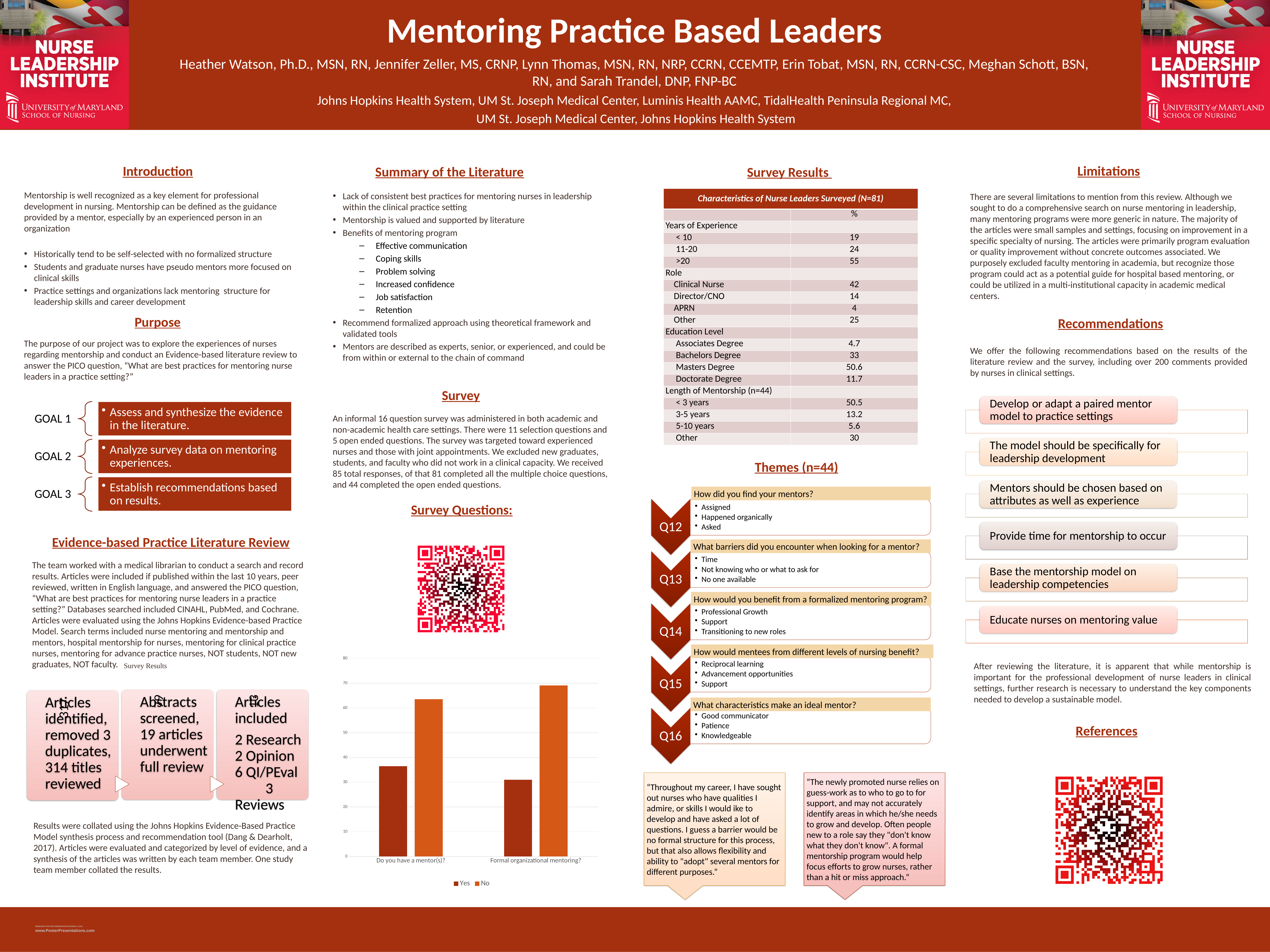
In the Survey Results chart, is the No value for "Do you have a mentor(s)?" greater or less than 60? greater In the Survey Results chart, is the Yes value for "Do you have a mentor(s)?" greater or less than 30? greater In the Survey Results chart, is the Yes value for "Do you have a mentor(s)?" greater or less than 40? less What are the two series named in the legend of the Survey Results chart? Yes and No How many categories are shown on the x axis of the Survey Results chart? 2 How many series does the legend of the Survey Results chart list? 2 In the Survey Results chart, which bar is the tallest? No for "Formal organizational mentoring?" In the Survey Results chart, for "Do you have a mentor(s)?", which is larger, Yes or No? No In the Survey Results chart, does the Yes series rise or fall from "Do you have a mentor(s)?" to "Formal organizational mentoring?"? fall What kind of chart is the Survey Results chart? bar chart